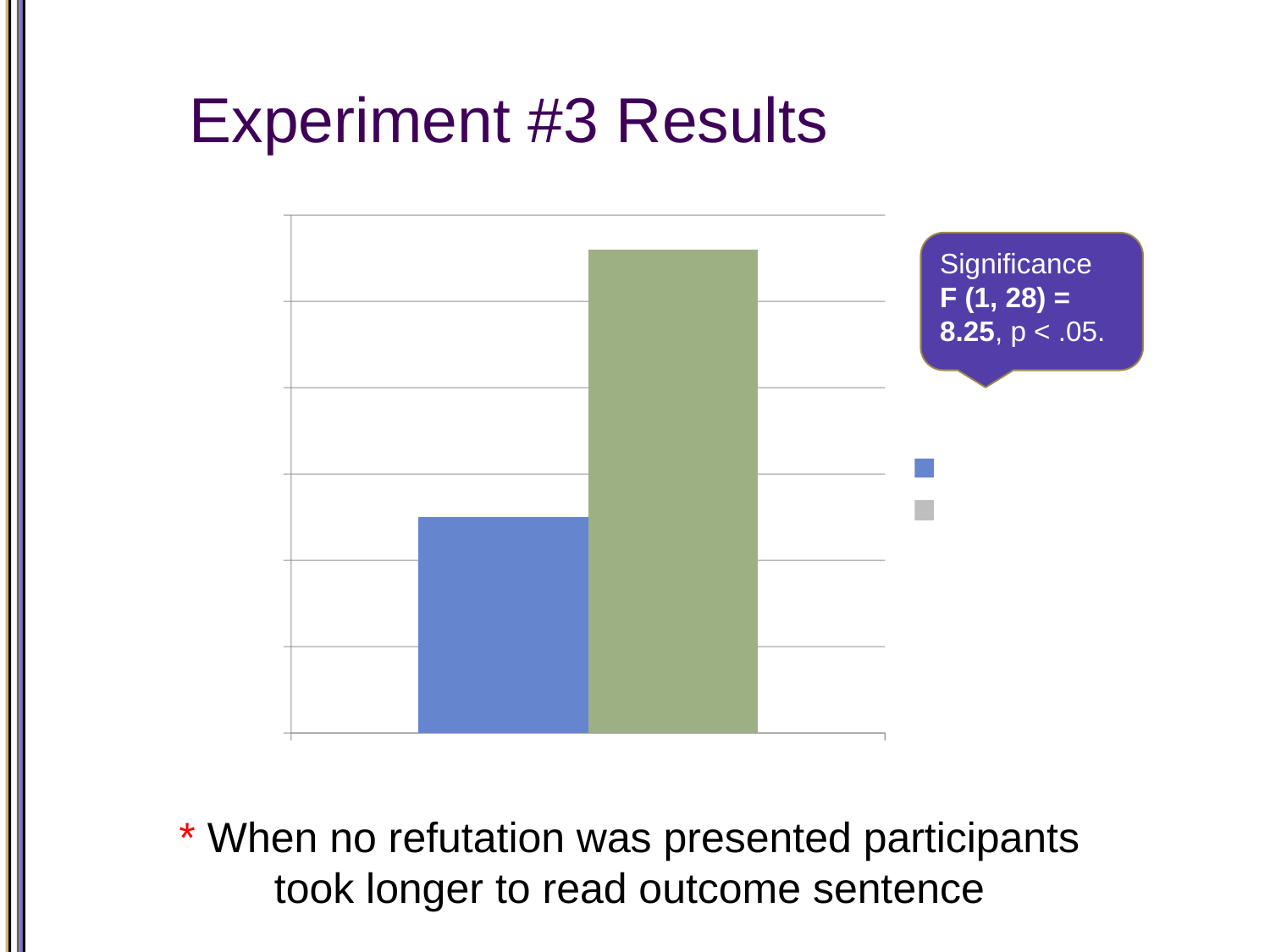
What kind of chart is shown on the slide? bar chart How many bars are plotted in the chart? 2 How many entries does the chart's legend list? 2 Which bar is the tallest in the chart? the green bar Which bar is taller, the blue bar or the green bar? the green bar Which bar is the shortest in the chart? the blue bar What colour is the bar on the right of the chart? green What colour is the bar on the left of the chart? blue